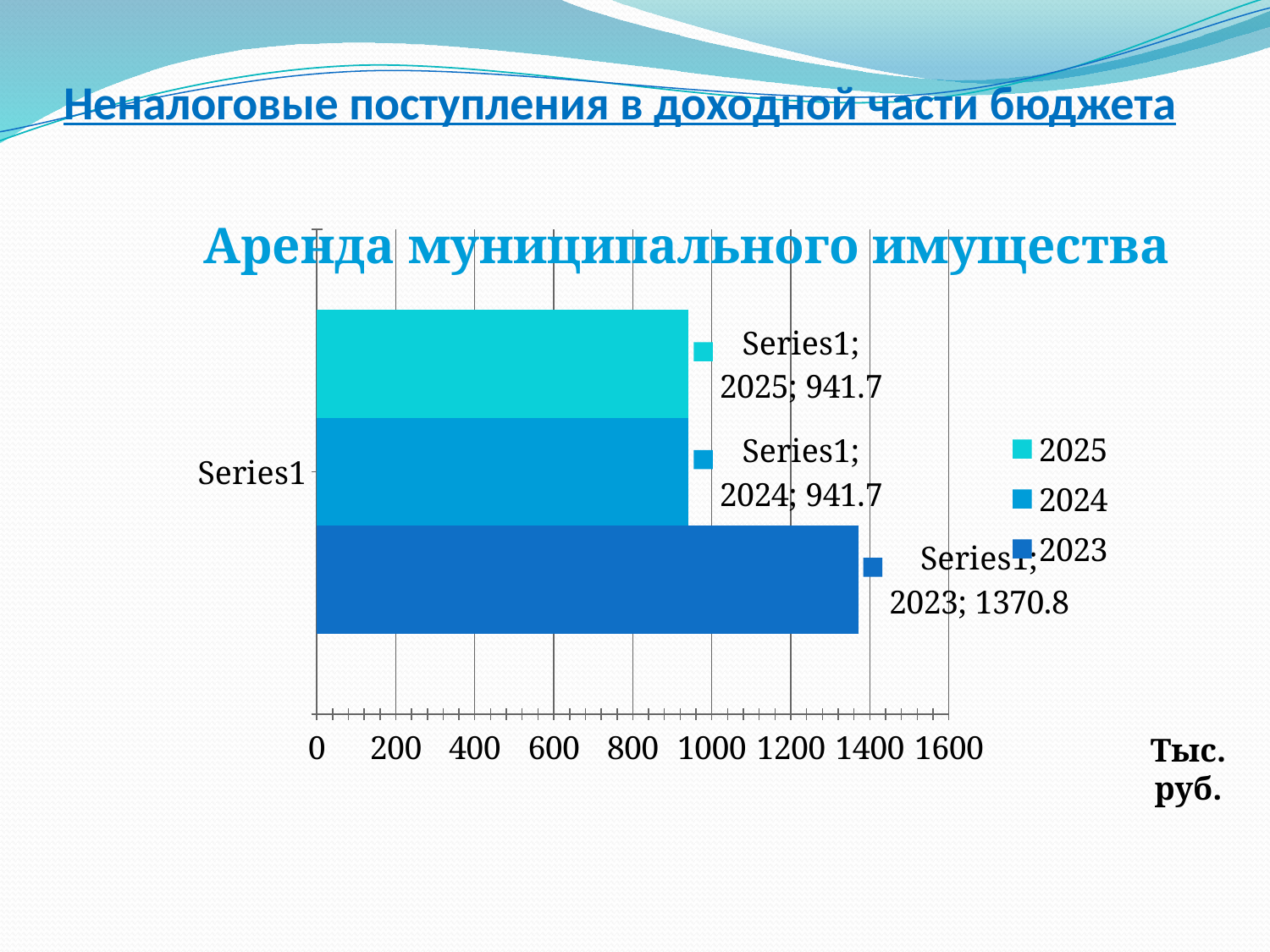
Is the value for 2023 greater or less than 1200? greater Which year has the highest value in the chart? 2023 What is the value for 2023 in the chart? 1370.8 How many entries does the legend list? 3 What is the value for 2025 in the chart? 941.7 Is the value for 2025 greater or less than 1000? less What is the value for 2024 in the chart? 941.7 What is the title of the chart? Аренда муниципального имущества What is the difference between the values for 2023 and 2024? 429.1 What kind of chart is shown on the slide? bar chart How many bars are plotted in the chart? 3 Which is larger, the value for 2023 or the value for 2025? 2023